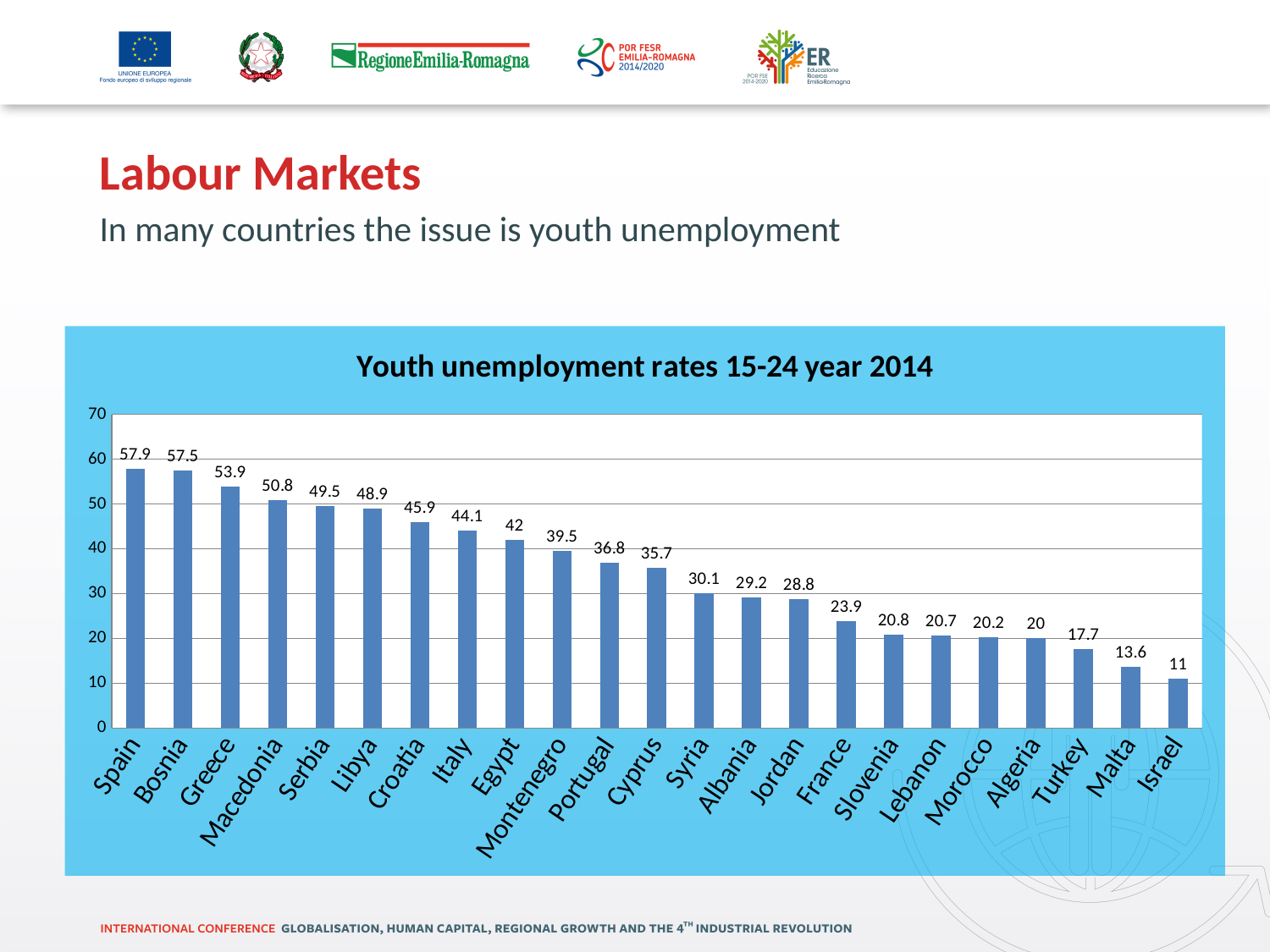
What is the difference between the youth unemployment rates of Greece and Portugal? 17.1 Which has a higher youth unemployment rate, Croatia or Cyprus? Croatia What kind of chart is used to show the youth unemployment rates? Bar chart What is the youth unemployment rate shown for France? 23.9 What is the youth unemployment rate shown for Italy? 44.1 Which has a higher youth unemployment rate, Turkey or Malta? Turkey What is the youth unemployment rate shown for Egypt? 42 Which country has the highest youth unemployment rate on the chart? Spain What is the difference between the youth unemployment rates of Spain and Israel? 46.9 What is the title of the chart? Youth unemployment rates 15-24 year 2014 How many countries are shown on the chart? 23 Which country has the lowest youth unemployment rate on the chart? Israel